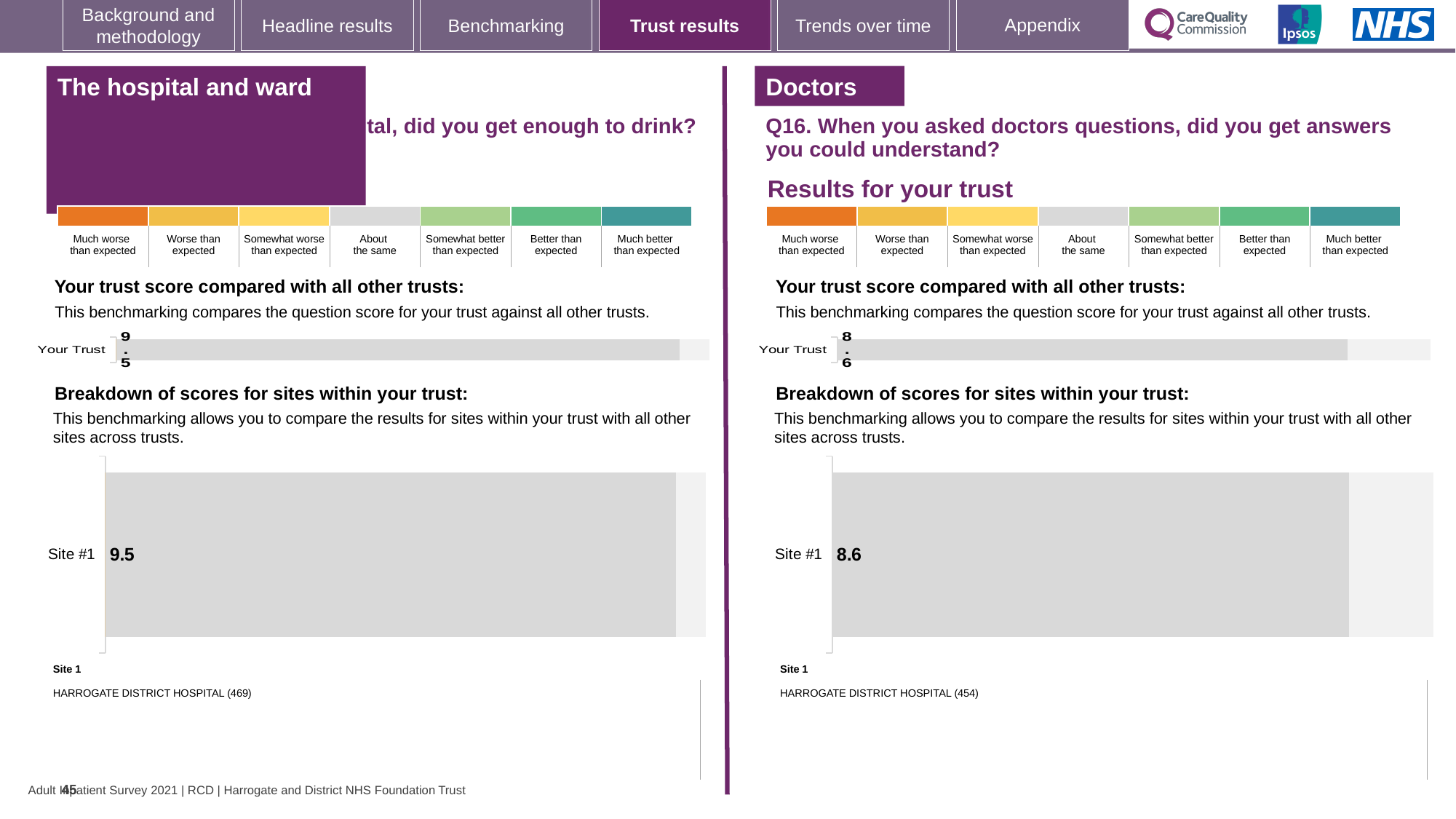
How many categories are plotted in the left-hand 'Your trust score compared with all other trusts' chart? 1 Which site is listed as Site 1 beneath the left-hand site breakdown chart? HARROGATE DISTRICT HOSPITAL (469) On the left-hand side of the slide, what is the value shown for Your Trust in the 'Your trust score compared with all other trusts' chart? 9.5 What type of chart is used for the 'Breakdown of scores for sites within your trust' on the left-hand side of the slide? Bar chart Which is larger: the Site #1 score in the left-hand site breakdown chart or the Site #1 score in the right-hand site breakdown chart? Left-hand (9.5) In the right-hand 'Breakdown of scores for sites within your trust' chart (Q16), what is the score for Site #1? 8.6 In the left-hand 'Breakdown of scores for sites within your trust' chart, what is the score for Site #1? 9.5 How many sites are plotted in the right-hand 'Breakdown of scores for sites within your trust' chart? 1 What is the difference between the Site #1 score in the left-hand site breakdown chart and the Site #1 score in the right-hand site breakdown chart? 0.9 On the right-hand side of the slide (Q16), what is the value shown for Your Trust in the 'Your trust score compared with all other trusts' chart? 8.6 Is the Your Trust score in the right-hand 'Your trust score compared with all other trusts' chart greater or less than the Your Trust score in the left-hand chart? less Which site is listed as Site 1 beneath the right-hand site breakdown chart? HARROGATE DISTRICT HOSPITAL (454)